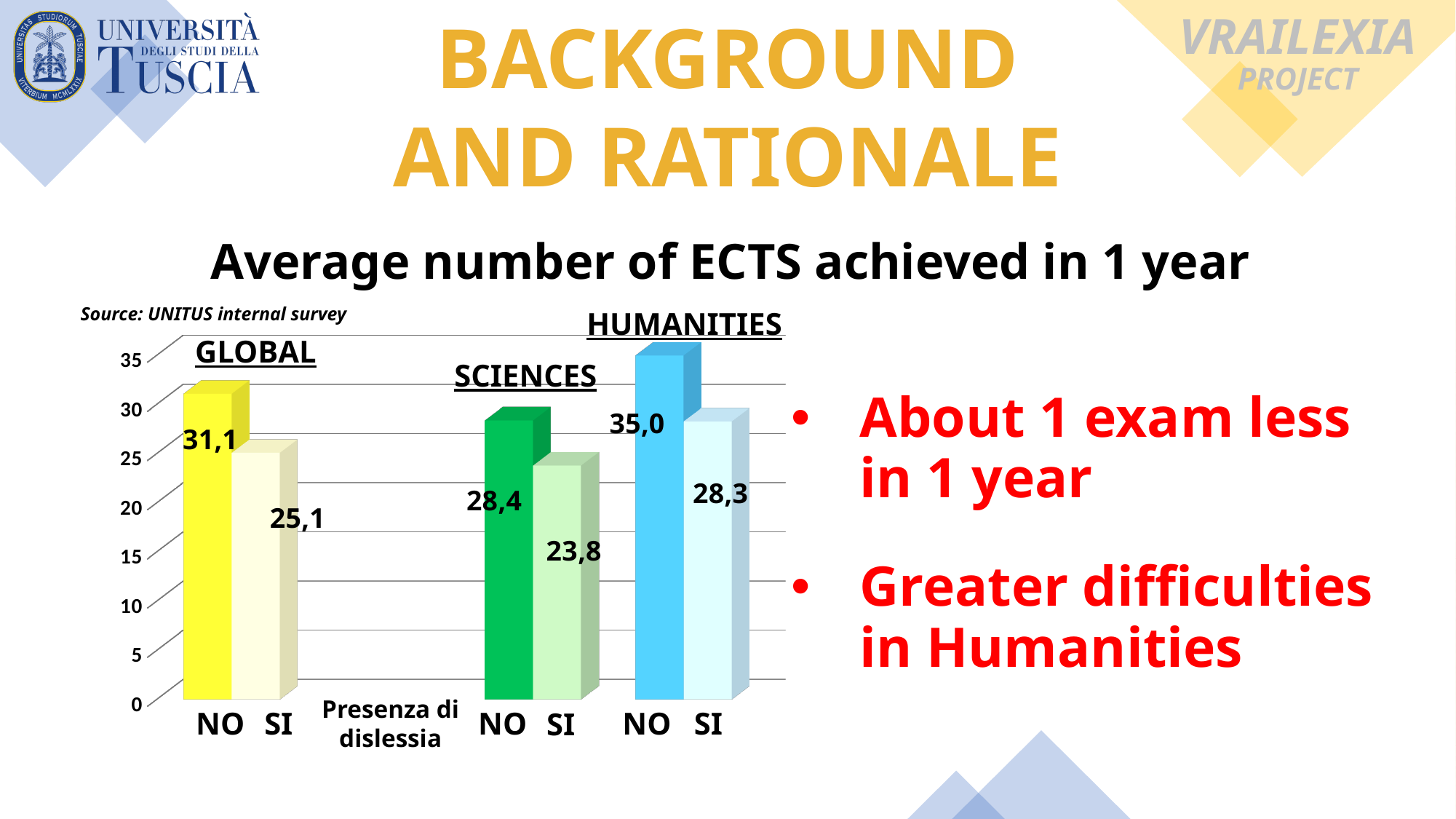
What kind of chart is shown on the slide? Bar chart Which bar shows the lowest average number of ECTS? SCIENCES SI What is the average number of ECTS for GLOBAL students with dyslexia (SI)? 25,1 What is the difference between the NO and SI values in the GLOBAL group? 6,0 What is the average number of ECTS for HUMANITIES students without dyslexia (NO)? 35,0 What is the difference between the NO and SI values in the HUMANITIES group? 6,7 What is the average number of ECTS for SCIENCES students with dyslexia (SI)? 23,8 How many bars are plotted in the chart? 6 Which bar shows the highest average number of ECTS? HUMANITIES NO What is the title of the chart? Average number of ECTS achieved in 1 year What is the average number of ECTS for GLOBAL students without dyslexia (NO)? 31,1 Which is larger: the SI value for HUMANITIES or the NO value for SCIENCES? NO value for SCIENCES